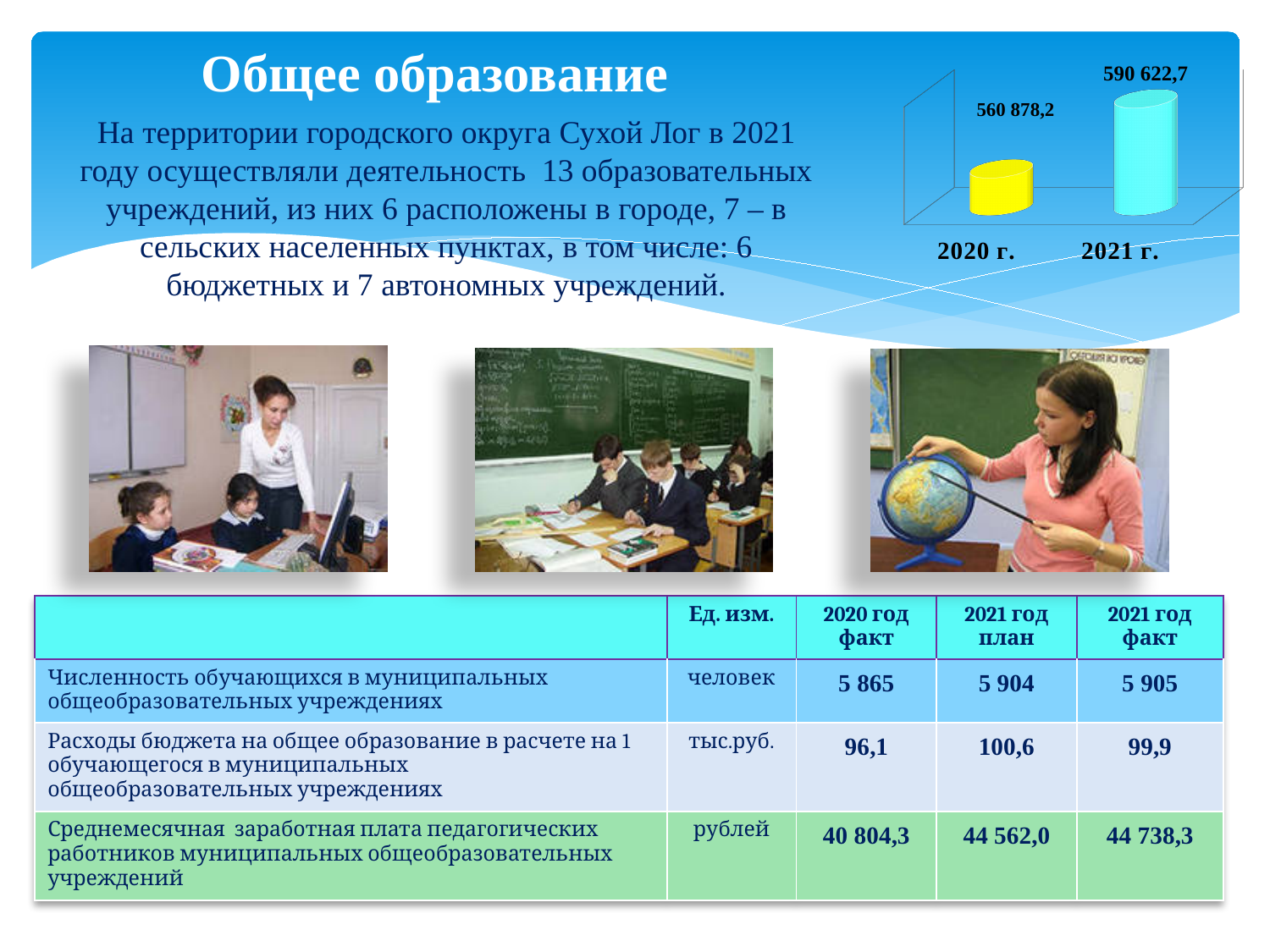
Is the value for 2020 г. larger or smaller than the value for 2021 г. in the chart? smaller What colour is the bar for 2021 г. in the chart? cyan What is the value shown for 2021 г. in the chart? 590 622,7 By how much does the value for 2021 г. exceed the value for 2020 г. in the chart? 29 744,5 Which year has the lower value in the chart? 2020 г. What is the value shown for 2020 г. in the chart? 560 878,2 What colour is the bar for 2020 г. in the chart? yellow What kind of chart is shown in the top right of the slide? bar chart Which year has the higher value in the chart? 2021 г. Does the value rise or fall from 2020 г. to 2021 г. in the chart? rise How many categories (years) are plotted in the chart? 2